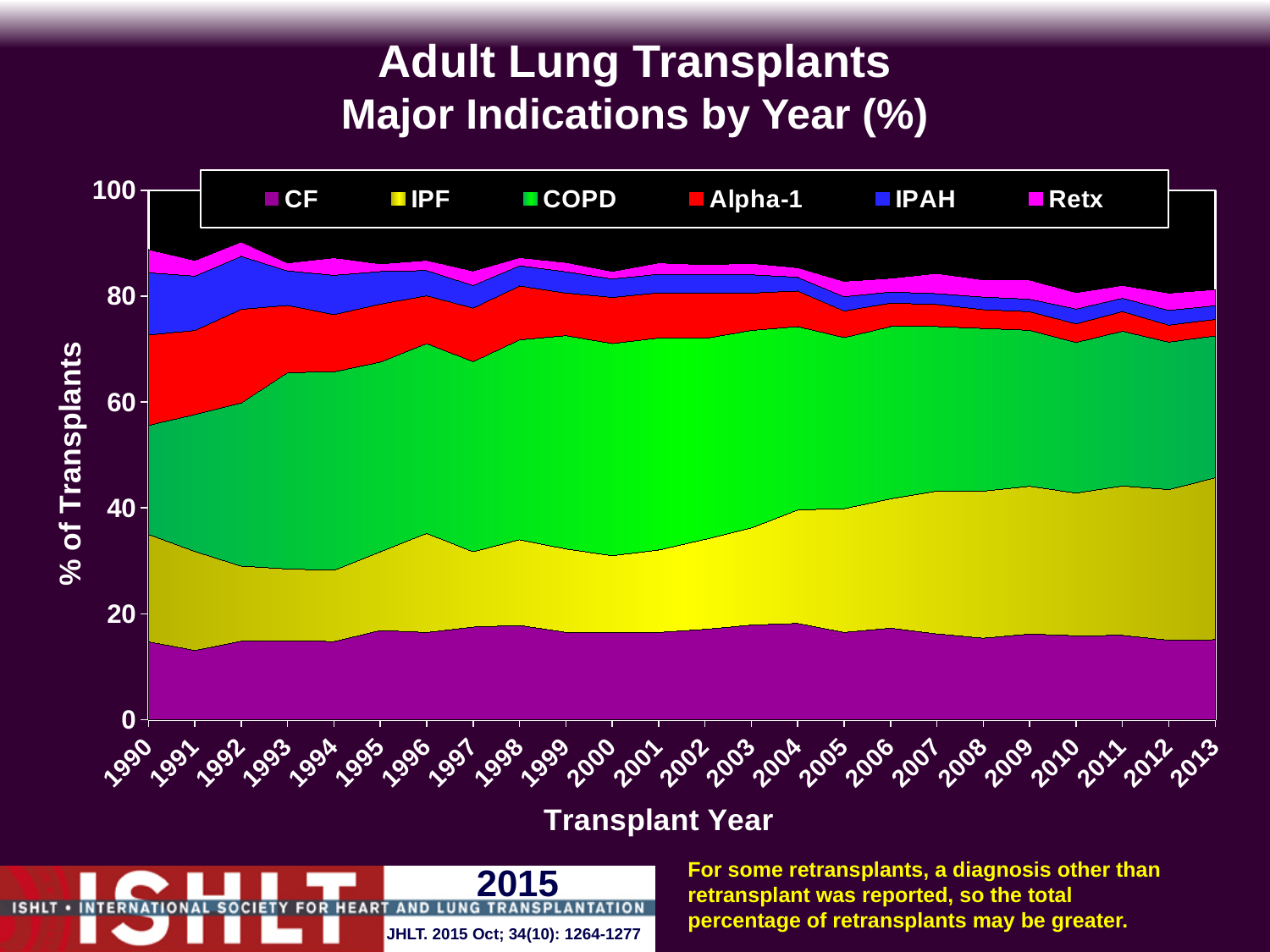
How many transplant years are shown along the x axis? 24 Is the combined total of all six indications in 1992 greater or less than 80? greater Does the share of transplants for IPF rise or fall from 1990 to 2013? Rise Does the share of transplants for Alpha-1 rise or fall from 1990 to 2013? Fall Is the cumulative top of the COPD band in 1990 greater or less than 60? less What kind of chart is shown on the slide? Stacked area chart Which indication is plotted as the bottom (purple) band of the chart? CF Is the value for CF in 1990 greater or less than 20? less Which indication has the largest share of transplants in 1995? COPD Is the share for Alpha-1 larger in 1990 or in 2013? 1990 How many series does the legend list? 6 What is the label of the y axis? % of Transplants